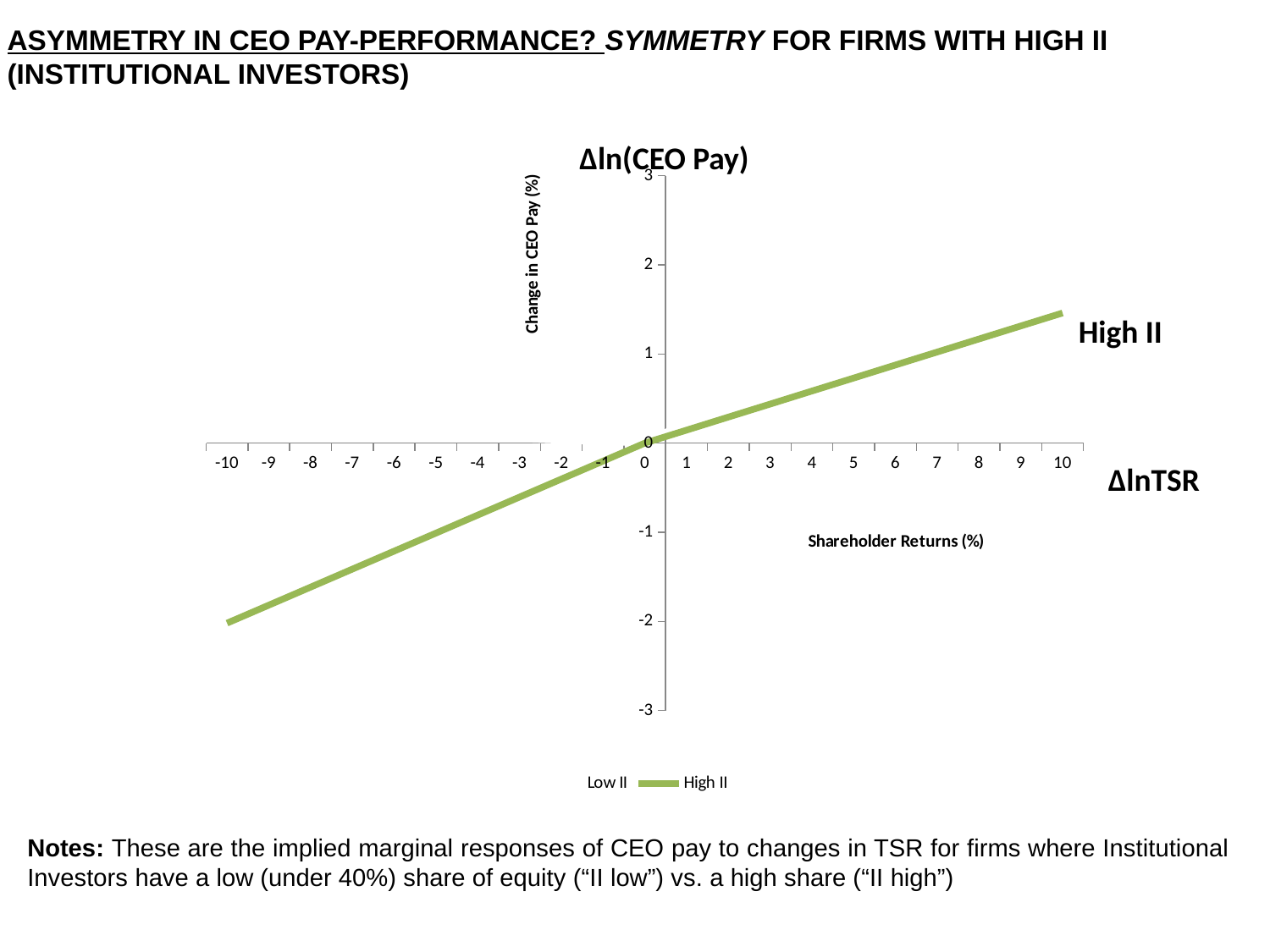
Is the value of the High II line at ΔlnTSR = 10 greater or less than 1? greater How many tick labels are shown on the x axis, from -10 to 10? 21 Which is larger for the High II line: the value at ΔlnTSR = 10 or at ΔlnTSR = -10? ΔlnTSR = 10 What is the title shown above the vertical axis of the chart? Δln(CEO Pay) Is the value of the High II line at ΔlnTSR = 10 greater or less than 2? less What are the two entries in the chart's legend? Low II and High II Is the value of the High II line at ΔlnTSR = -10 greater or less than -3? greater How many series does the legend list? 2 What is the highest value labelled on the y axis? 3 Does the High II line rise or fall as ΔlnTSR increases along the x axis? rises What kind of chart is shown on the slide? line chart